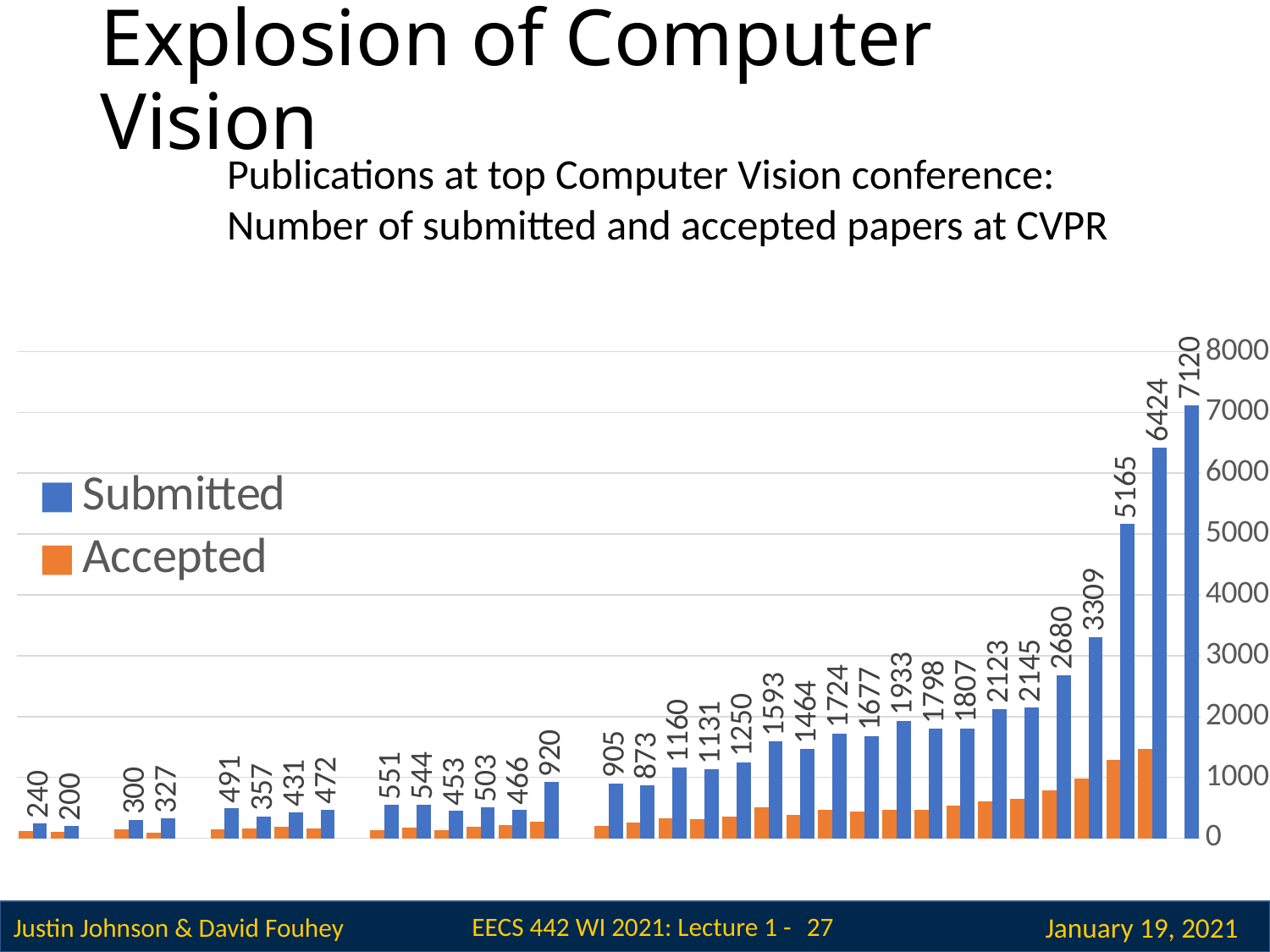
What is the data label on the second-tallest Submitted bar? 6424 In the group where Submitted is 6424, which is larger, Submitted or Accepted? Submitted Is the tallest Accepted bar greater or less than 2000? less Do the Submitted values generally rise or fall from left to right along the x axis? rise What is the difference between the two highest Submitted values, 7120 and 6424? 696 What colour are the Submitted bars? blue How many Submitted bars are plotted on the chart? 33 What are the two series named in the legend? Submitted and Accepted What is the highest Submitted value shown on the chart? 7120 How many series does the legend list? 2 What kind of chart is shown on the slide? bar chart What is the lowest Submitted value labelled on the chart? 200